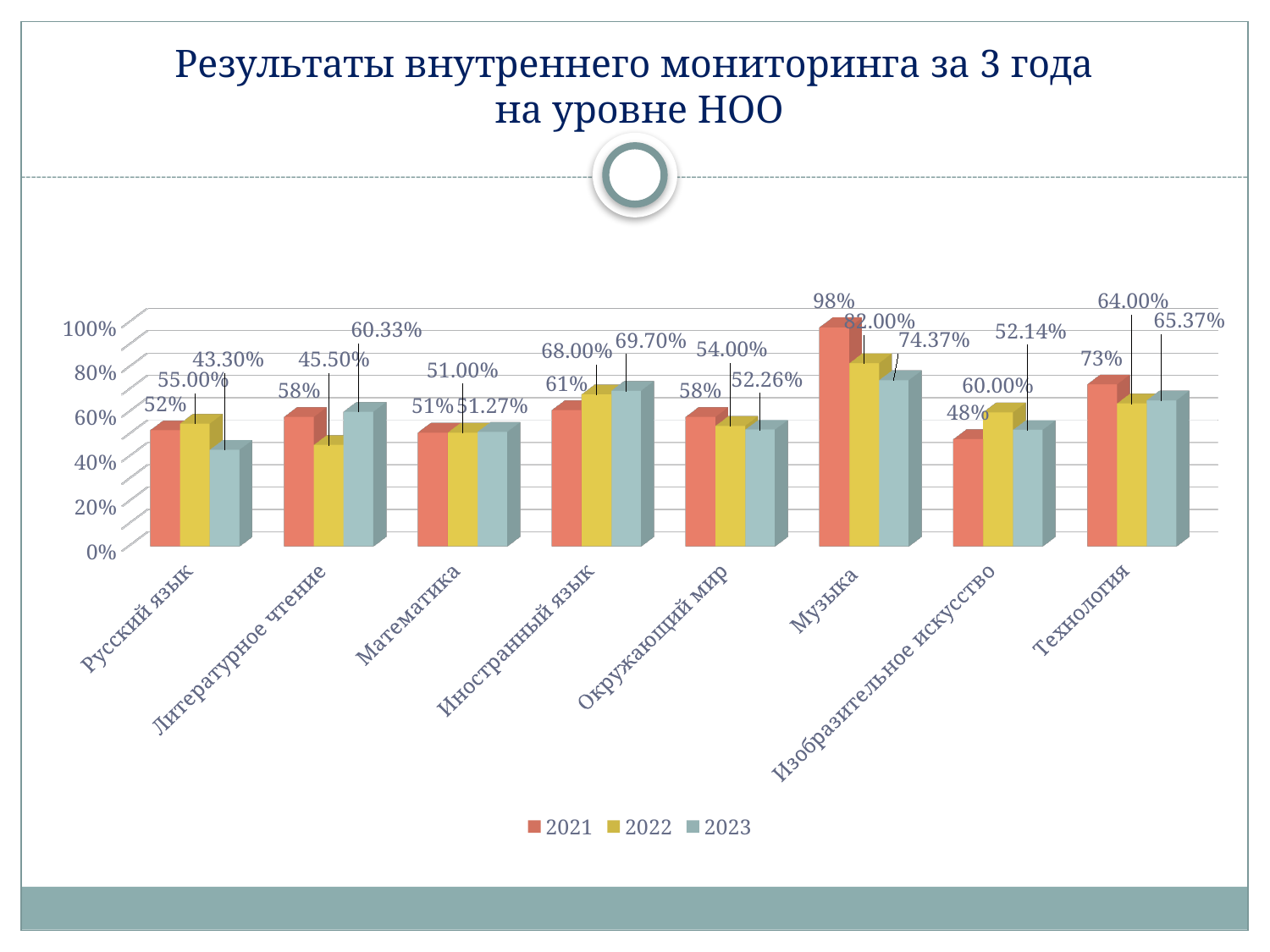
Which category has the lowest value in the 2021 series? Изобразительное искусство Which category has the lowest value in the 2023 series? Русский язык How many series does the legend list? 3 How many categories are shown on the x axis? 8 Is the 2023 value for Музыка greater or less than 60%? greater What is the value for Изобразительное искусство in the 2022 series? 60.00% What kind of chart is shown on the slide? bar chart For Технология, which is larger: the 2021 value or the 2022 value? 2021 What is the difference between the 2023 and 2021 values for Иностранный язык? 8.70% Which category has the highest value in the 2021 series? Музыка What is the value for Музыка in the 2021 series? 98% What is the value for Литературное чтение in the 2023 series? 60.33%